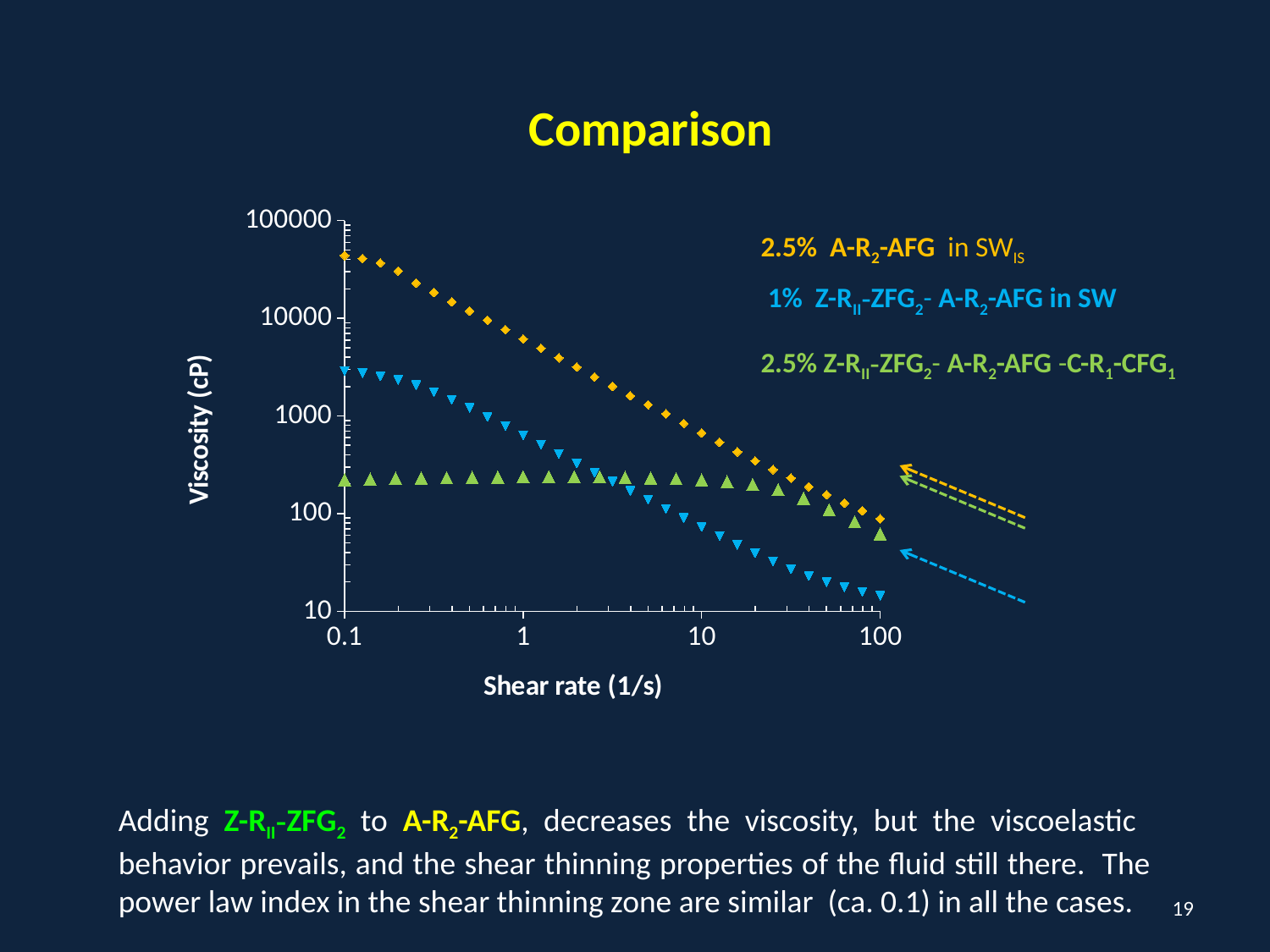
How many data series are plotted on the chart? 3 What kind of chart is shown on the slide? scatter chart Does the viscosity of 2.5% A-R2-AFG in SWIS rise or fall as the shear rate increases? fall Which series has the highest viscosity at a shear rate of 0.1? 2.5% A-R2-AFG in SWIS What is the title of the chart? Comparison Is the viscosity of 2.5% Z-RII-ZFG2-A-R2-AFG-C-R1-CFG1 at a shear rate of 0.1 greater or less than 1000? less Which series has the lowest viscosity at a shear rate of 100? 1% Z-RII-ZFG2-A-R2-AFG in SW Does the viscosity of 1% Z-RII-ZFG2-A-R2-AFG in SW rise or fall as the shear rate increases? fall What is the label of the y axis? Viscosity (cP) Is the viscosity of 1% Z-RII-ZFG2-A-R2-AFG in SW at a shear rate of 100 greater or less than 100? less Is the viscosity of 1% Z-RII-ZFG2-A-R2-AFG in SW at a shear rate of 0.1 greater or less than 10000? less